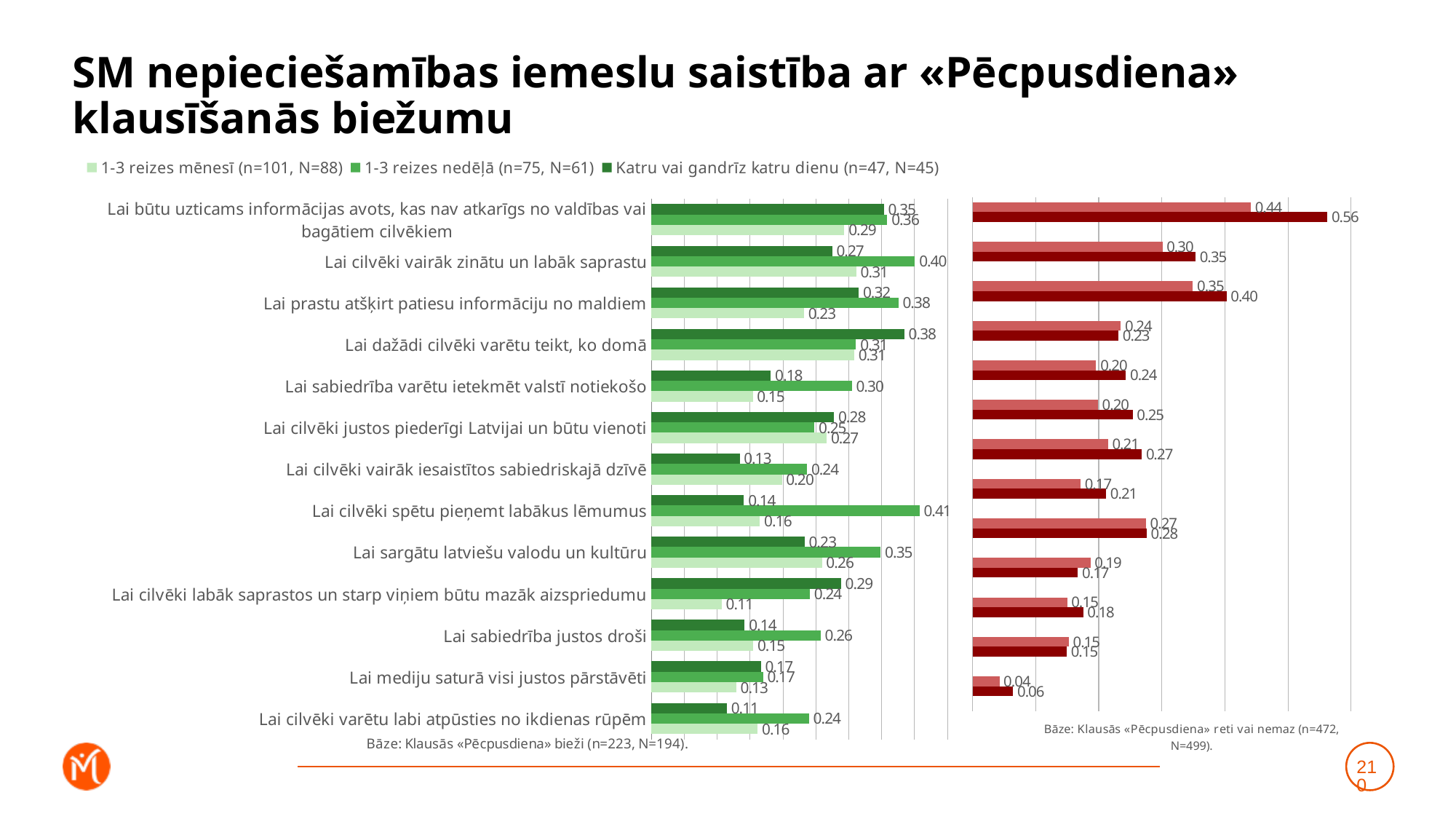
On the left (green) chart, which category has the highest value in the '1-3 reizes nedēļā (n=75, N=61)' series? Lai cilvēki spētu pieņemt labākus lēmumus On the right (red) chart, what is the highest value shown by any bar? 0.56 On the left (green) chart, what is the value for 'Lai cilvēki labāk saprastos un starp viņiem būtu mazāk aizspriedumu' in the '1-3 reizes mēnesī (n=101, N=88)' series? 0.11 On the left (green) chart, for 'Lai sabiedrība varētu ietekmēt valstī notiekošo', which is larger: the '1-3 reizes nedēļā' value or the '1-3 reizes mēnesī' value? 1-3 reizes nedēļā On the right (red) chart, what is the lowest value shown by any bar? 0.04 On the left (green) chart, what is the difference between the '1-3 reizes nedēļā' and 'Katru vai gandrīz katru dienu' values for 'Lai cilvēki spētu pieņemt labākus lēmumus'? 0.27 How many categories are shown on the left (green) chart? 13 On the left (green) chart, what is the value for 'Lai cilvēki spētu pieņemt labākus lēmumus' in the '1-3 reizes nedēļā (n=75, N=61)' series? 0.41 On the left (green) chart, which category has the lowest value in the 'Katru vai gandrīz katru dienu (n=47, N=45)' series? Lai cilvēki varētu labi atpūsties no ikdienas rūpēm How many series does the legend of the left (green) chart list? 3 On the left (green) chart, what is the value for 'Lai dažādi cilvēki varētu teikt, ko domā' in the 'Katru vai gandrīz katru dienu (n=47, N=45)' series? 0.38 What type of chart is the right (red) chart? Bar chart